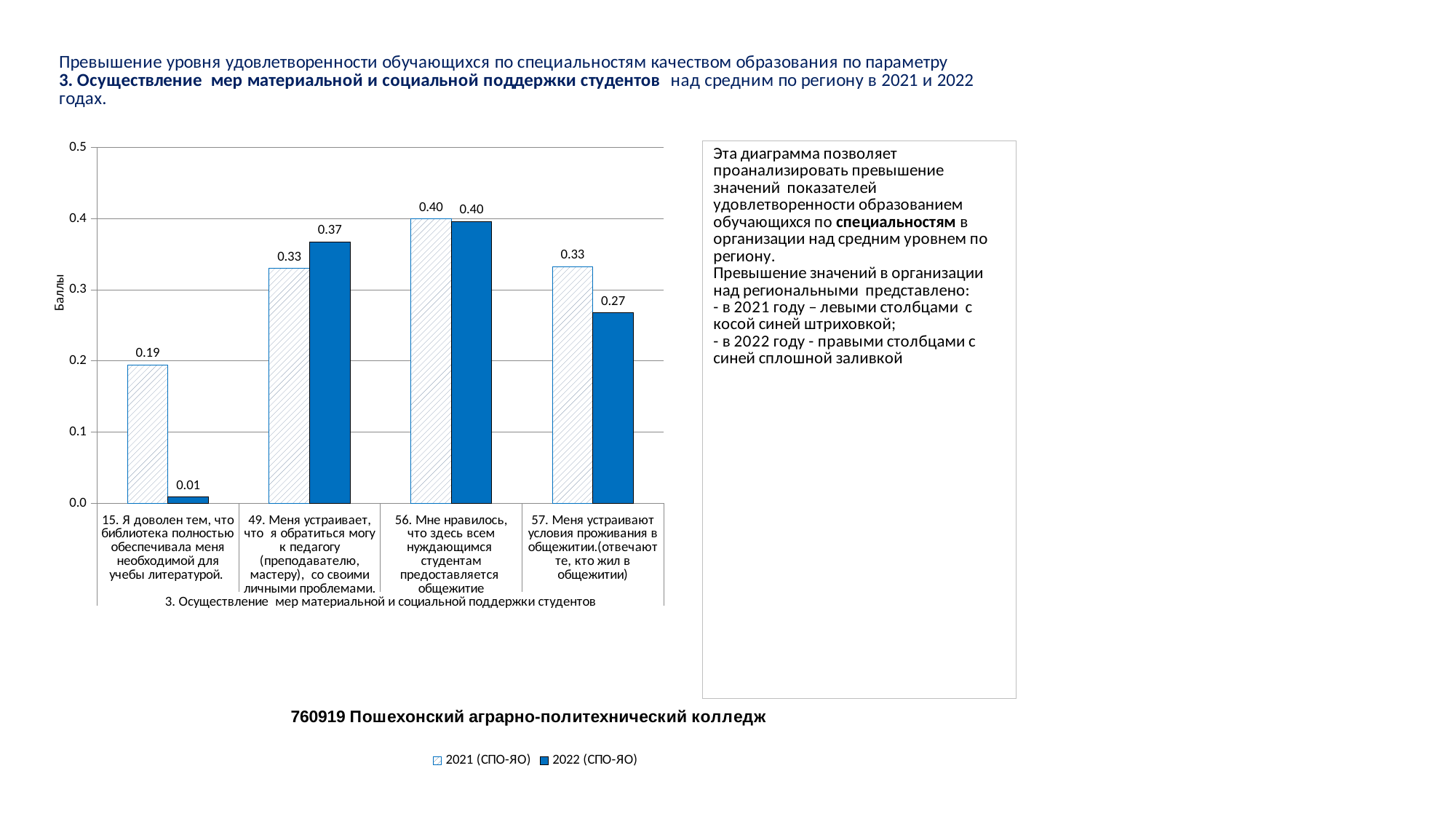
What is the value for 2022 (СПО-ЯО) for item 15 (library provided necessary literature)? 0.01 What kind of chart is shown on the slide? Bar chart Is the 2022 (СПО-ЯО) value for item 49 greater or less than 0.3? greater How many series does the chart legend list? 2 For item 49 (approaching a teacher with personal problems), which series has the larger value, 2021 (СПО-ЯО) or 2022 (СПО-ЯО)? 2022 (СПО-ЯО) What is the value for 2022 (СПО-ЯО) for item 57 (living conditions in the dormitory)? 0.27 What is the value for 2022 (СПО-ЯО) for item 49 (can approach a teacher with personal problems)? 0.37 What is the difference between the 2021 and 2022 values for item 15 (library literature)? 0.18 Which item has the lowest value for 2022 (СПО-ЯО)? 15. Я доволен тем, что библиотека полностью обеспечивала меня необходимой для учебы литературой. How many items (categories) are shown on the x axis of the chart? 4 Which item has the highest value for 2022 (СПО-ЯО)? 56. Мне нравилось, что здесь всем нуждающимся студентам предоставляется общежитие What is the value for 2021 (СПО-ЯО) for item 15 (library provided necessary literature)? 0.19